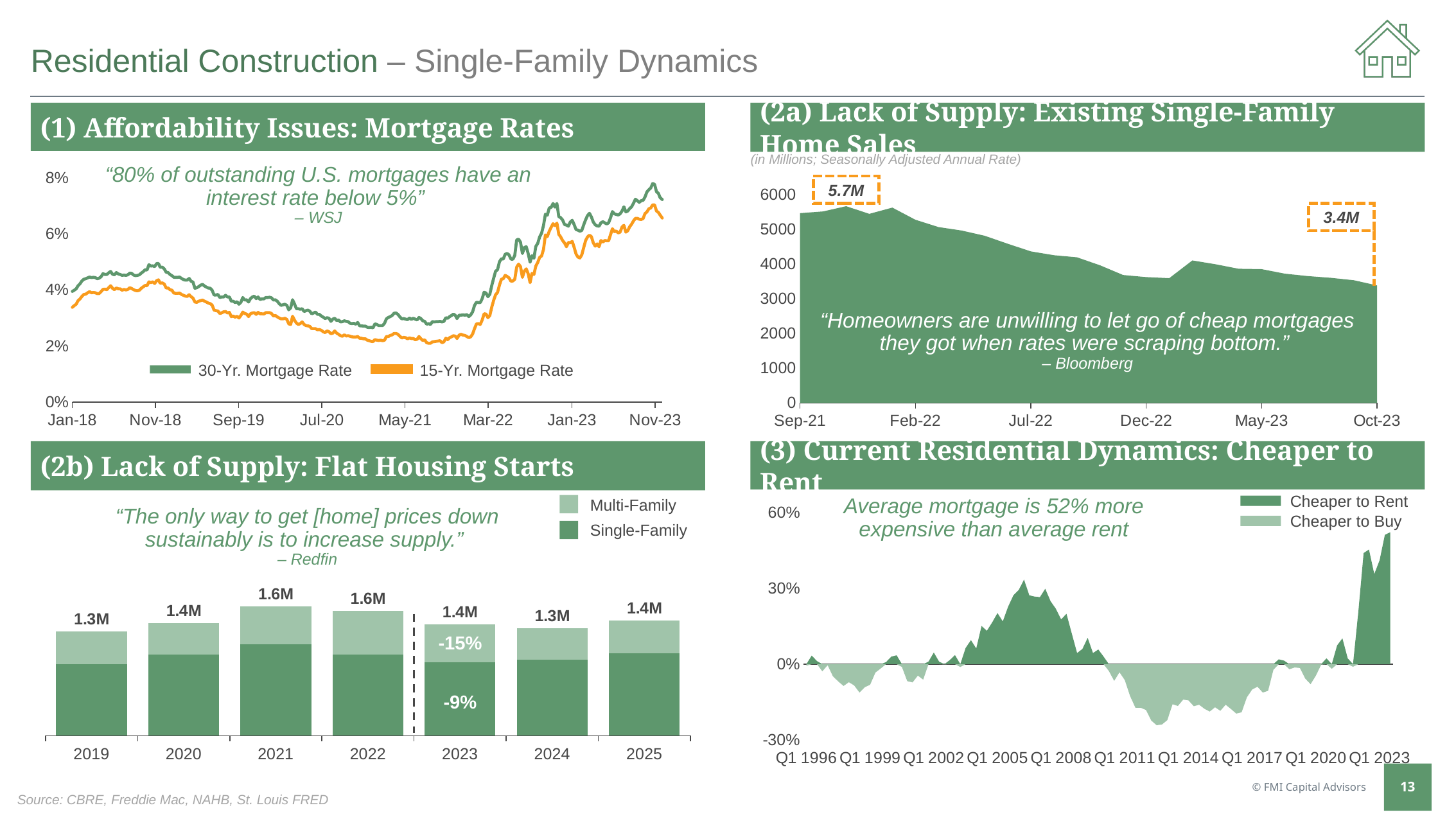
In the (2b) Flat Housing Starts chart, what is the difference between the 2021 total and the 2019 total? 0.3M In the (2a) Existing Single-Family Home Sales chart, do sales rise or fall from Sep-21 to Oct-23? Fall What kind of chart is the (2b) Lack of Supply: Flat Housing Starts chart? Bar chart In the (2a) Existing Single-Family Home Sales chart, what value is labeled at Oct-23? 3.4M In the (2b) Flat Housing Starts chart, which year has the larger total: 2021 or 2024? 2021 In the (3) Current Residential Dynamics: Cheaper to Rent chart, what are the two legend entries? Cheaper to Rent and Cheaper to Buy In the (2b) Flat Housing Starts chart, what is the total housing starts value labeled for 2021? 1.6M In the (2a) Existing Single-Family Home Sales chart, what is the difference between the 5.7M label and the 3.4M label? 2.3M In the (1) Affordability Issues: Mortgage Rates chart, is the 30-Yr. Mortgage Rate at Nov-23 greater or less than 6%? greater How many series does the legend of the (2b) Flat Housing Starts chart list? 2 In the (2b) Flat Housing Starts chart, what is the total value labeled for 2024? 1.3M How many years are shown on the x axis of the (2b) Flat Housing Starts chart? 7